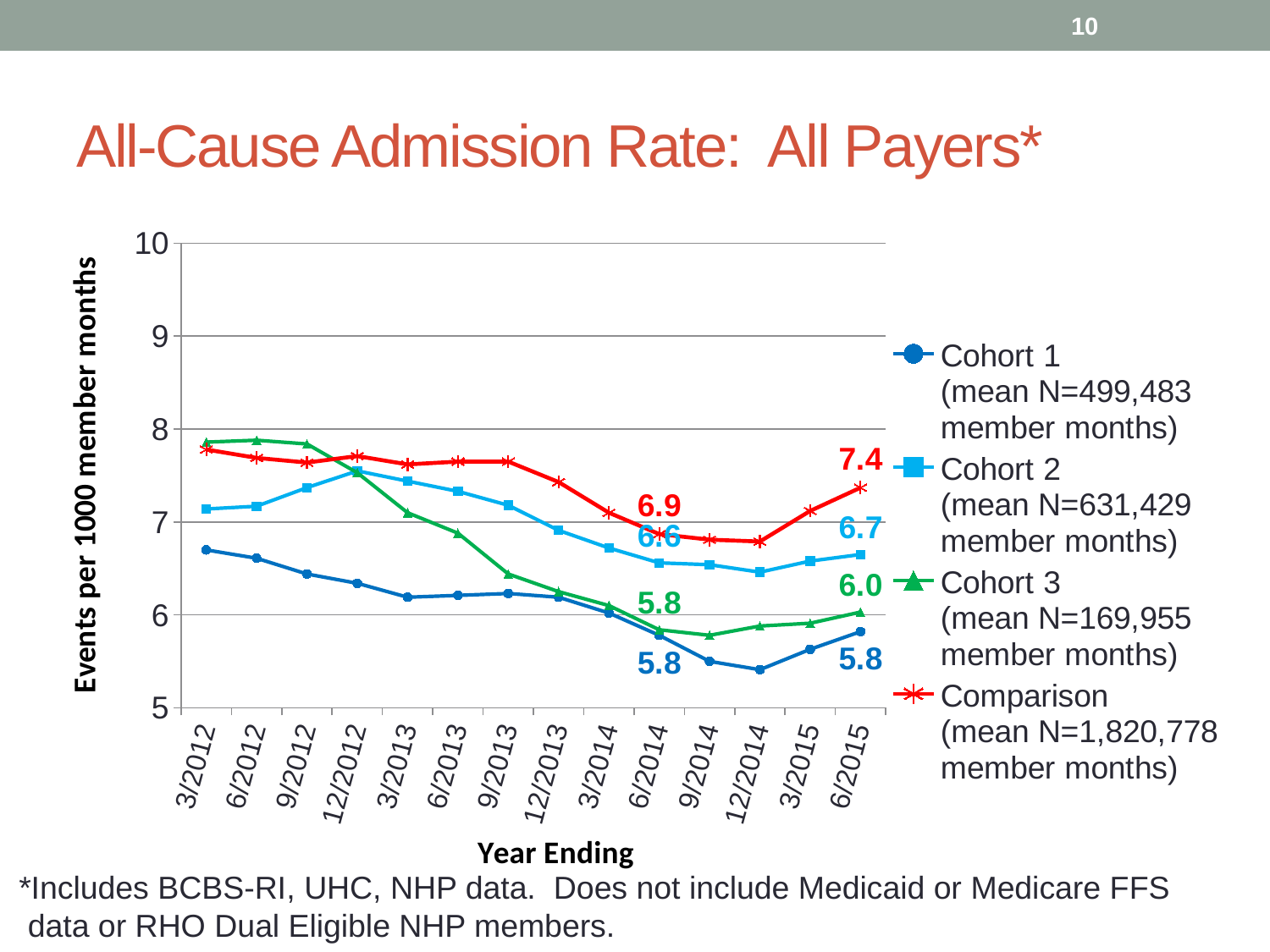
How many year-ending points are shown along the x axis? 14 What is the value for Cohort 3 at 6/2015? 6.0 What is the title of the y axis? Events per 1000 member months How many series does the legend list? 4 What is the difference between the Comparison value and the Cohort 1 value at 6/2015? 1.6 What is the value for the Comparison series at 6/2015? 7.4 Is the value for Cohort 1 at 3/2012 greater or less than 7? less What is the value for Cohort 2 at 6/2014? 6.6 What kind of chart is shown on the slide? Line chart By how much did the Comparison value change from 6/2014 to 6/2015? 0.5 At 6/2015, which is larger: Cohort 2 or Cohort 3? Cohort 2 Which series has the highest value at 6/2015? Comparison